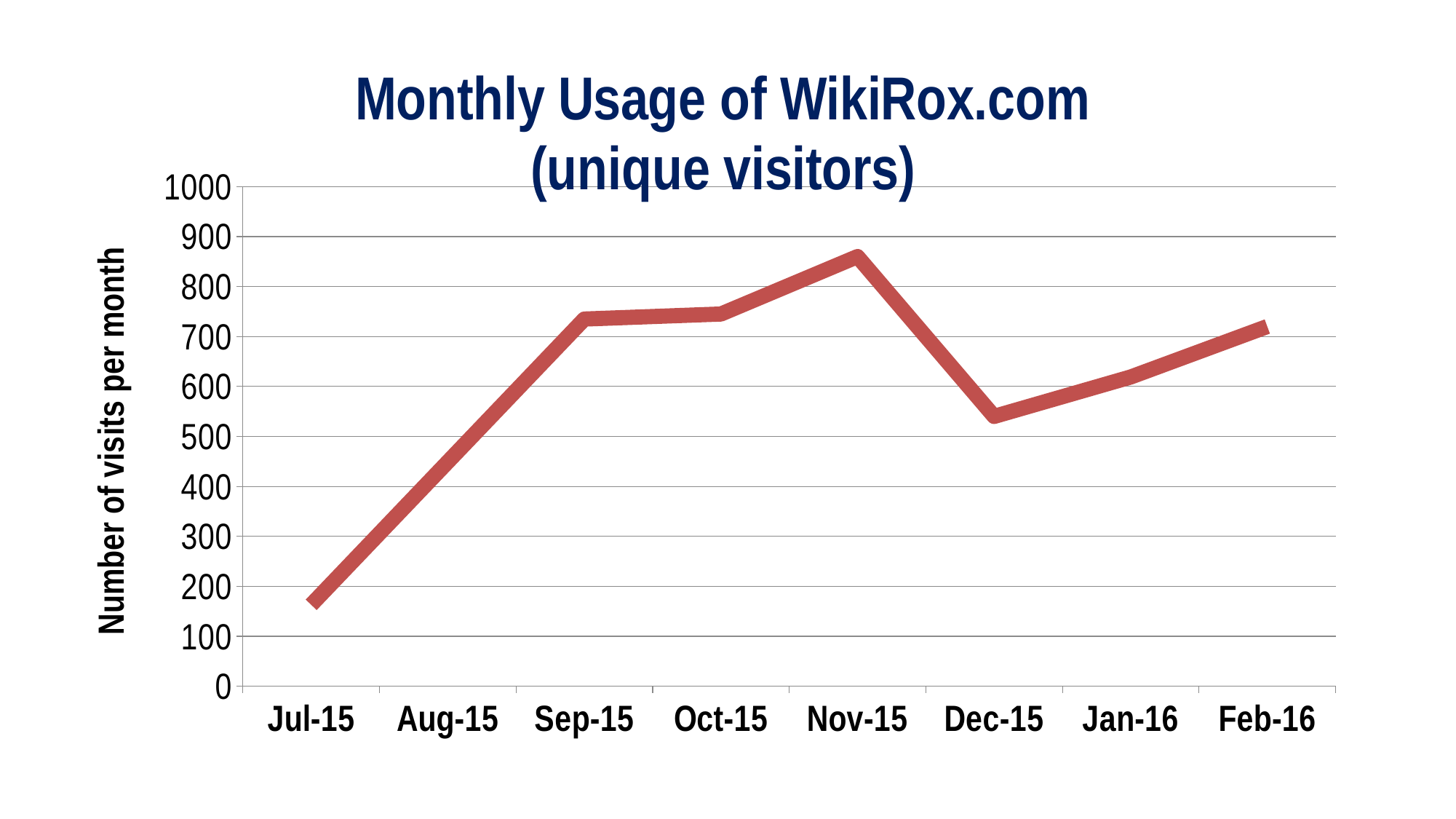
Which month has the highest number of unique visitors? Nov-15 Do the values rise or fall from Jul-15 to Nov-15? rise How many months are plotted on the x axis? 8 What kind of chart is shown on the slide? line chart Is the value for Dec-15 greater or less than 500? greater Is the value for Nov-15 greater or less than 800? greater Which month has more unique visitors, Nov-15 or Dec-15? Nov-15 What is the label on the vertical axis? Number of visits per month Which month has the lowest number of unique visitors? Jul-15 Is the value for Jul-15 greater or less than 200? less